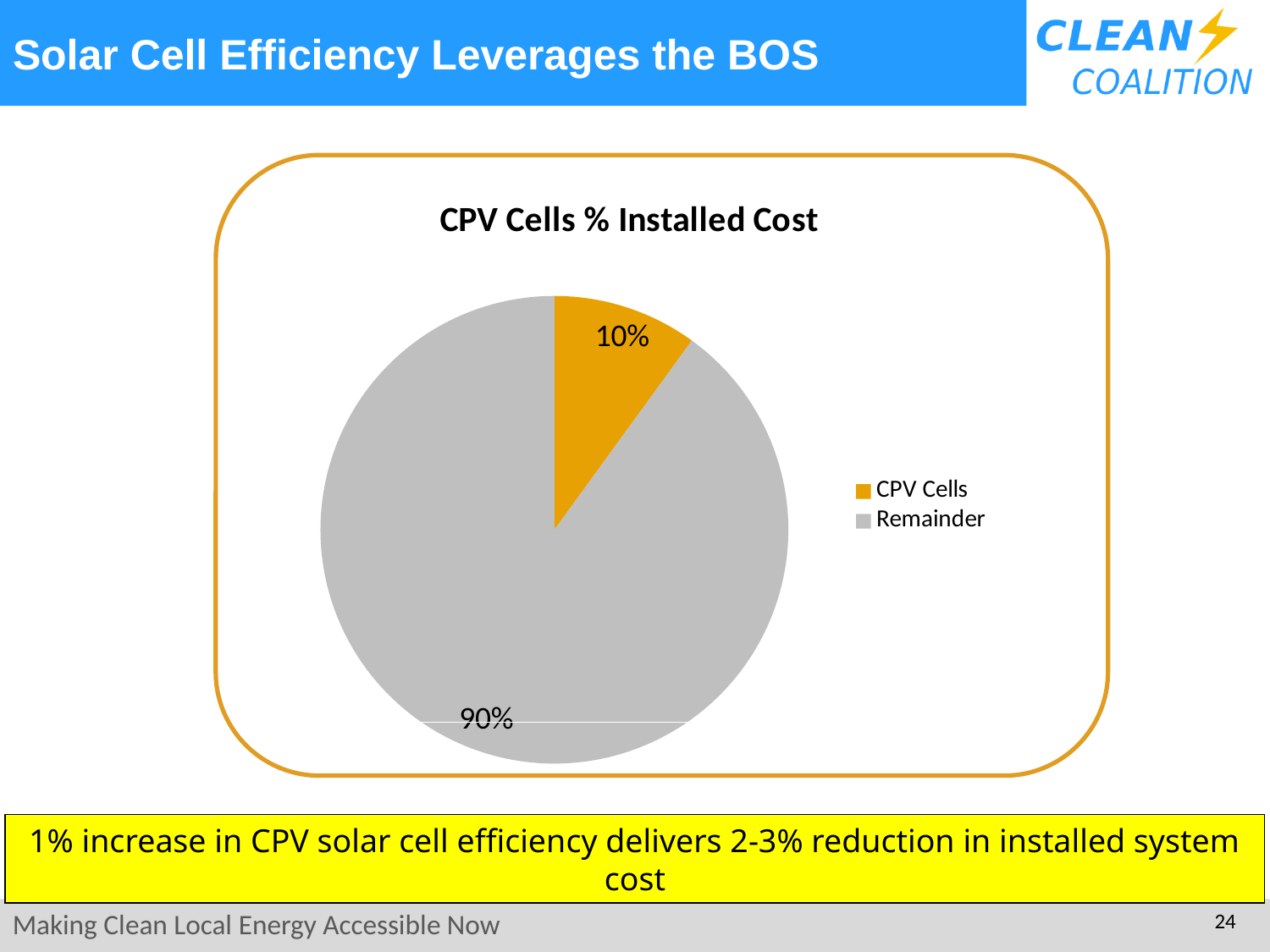
How many entries does the legend list? 2 What colour is the CPV Cells slice? orange Which is larger, the CPV Cells slice or the Remainder slice? Remainder Which slice of the pie is the smallest? CPV Cells Which slice of the pie is the largest? Remainder What is the title of the chart? CPV Cells % Installed Cost What is the difference in percentage points between the Remainder slice and the CPV Cells slice? 80 How many slices does the pie chart have? 2 What percentage of installed cost is attributed to the Remainder? 90% What kind of chart is shown on the slide? pie chart What percentage of installed cost is attributed to CPV Cells? 10% What share of the pie does the CPV Cells slice represent? 10%